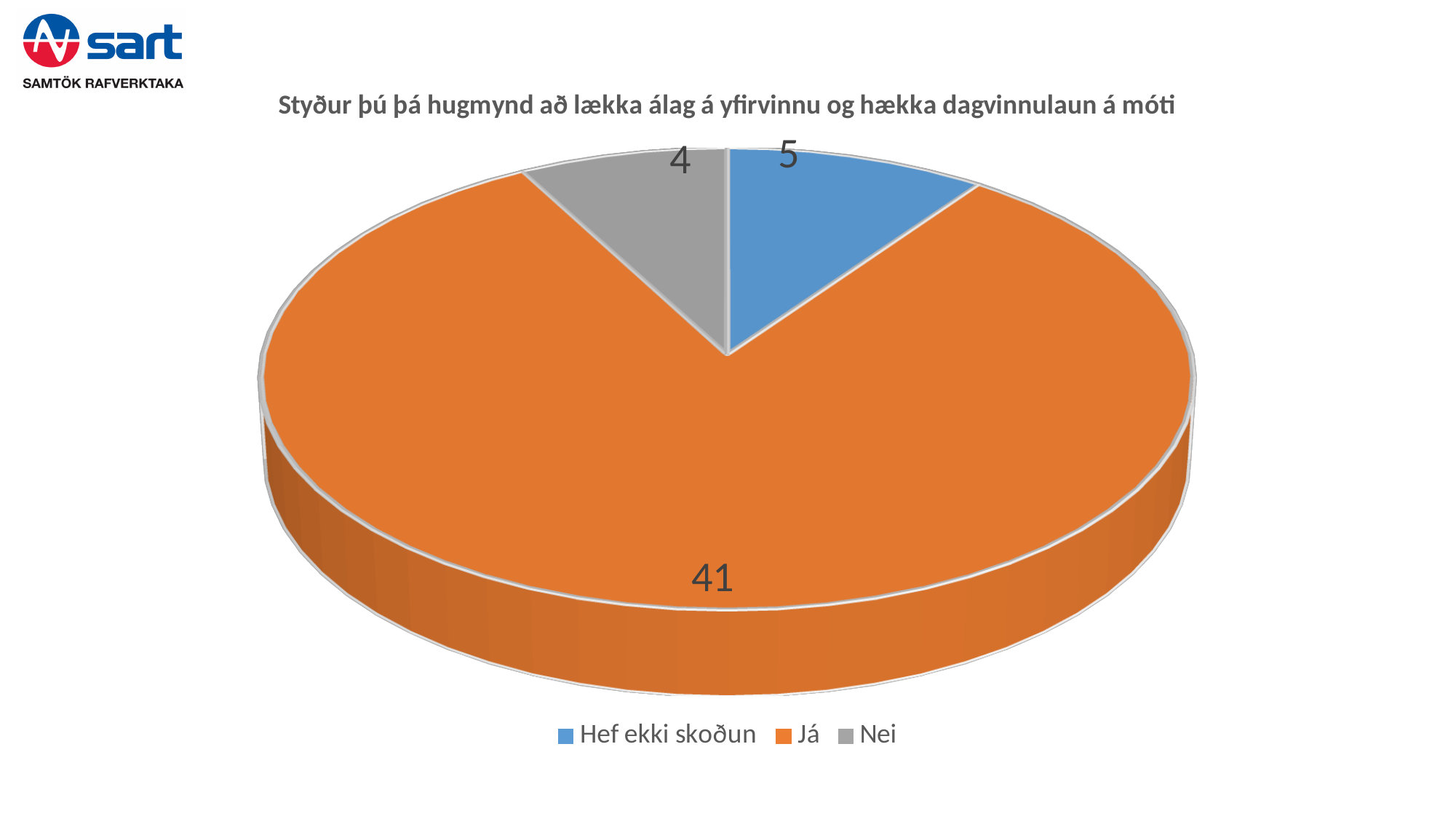
How many categories are shown in the pie chart? 3 What kind of chart is shown on the slide? Pie chart Which category has the largest slice of the pie? Já What value is shown for the "Já" slice? 41 Which is larger, the value for "Hef ekki skoðun" or the value for "Nei"? Hef ekki skoðun Which category has the smallest slice of the pie? Nei What colour is used for the "Nei" slice? Grey What value is shown for the "Hef ekki skoðun" slice? 5 What is the difference between the values for "Já" and "Hef ekki skoðun"? 36 What is the total of all the values shown in the pie chart? 50 What value is shown for the "Nei" slice? 4 What share of the pie does the "Já" slice represent? 82%